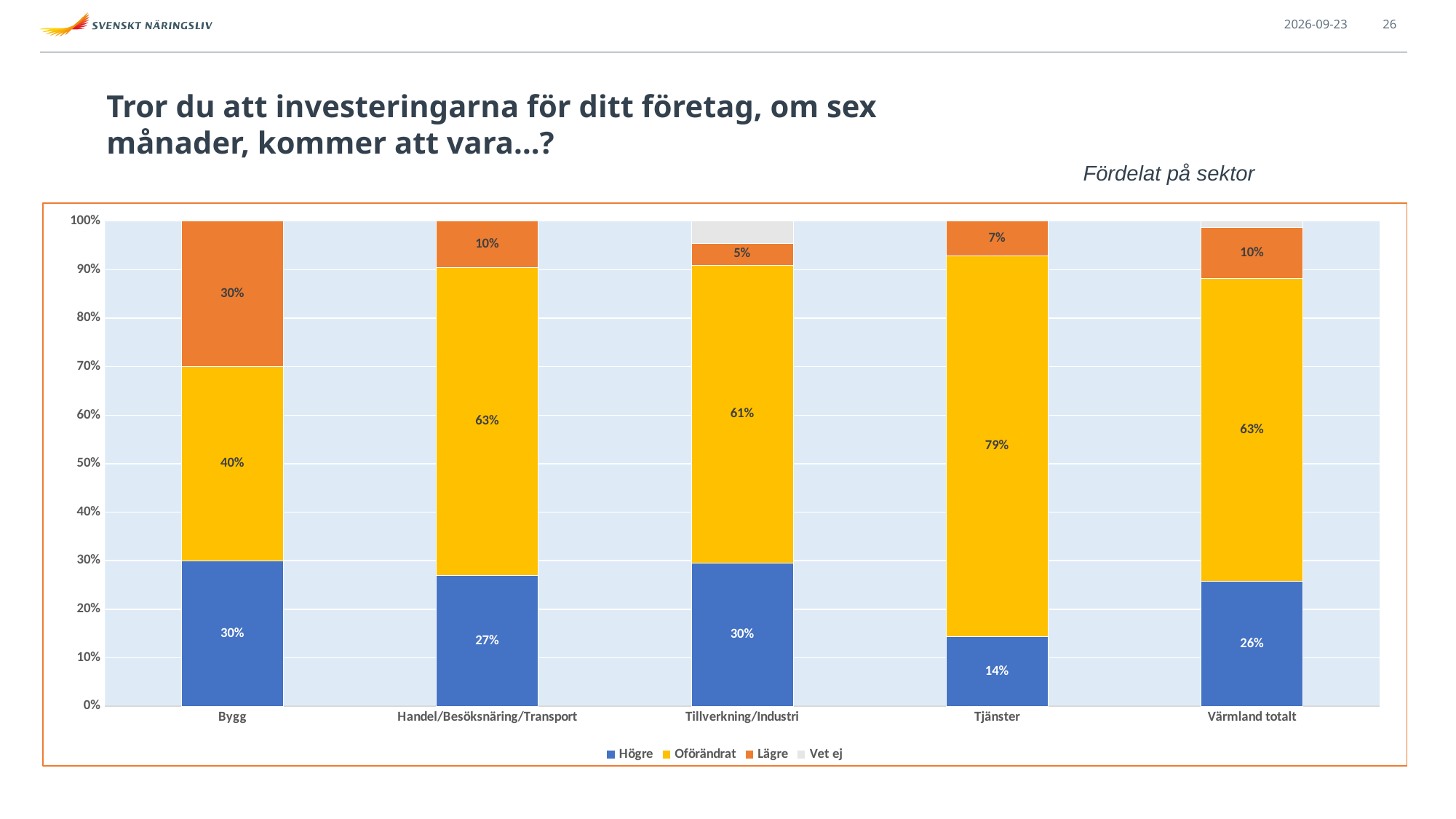
Which sector has the lowest Högre value? Tjänster What kind of chart is shown on the slide? Stacked bar chart What is the value of Oförändrat for Tillverkning/Industri? 61% How many sectors (categories) are shown on the x axis? 5 What is the difference between the Lägre value for Bygg and the Lägre value for Tjänster? 23% How many series does the legend list? 4 Which sector has the highest Oförändrat value? Tjänster What is the value of Oförändrat for Värmland totalt? 63% Which series is shown in orange in the legend? Lägre Which is larger: the Högre value for Handel/Besöksnäring/Transport or the Högre value for Tillverkning/Industri? Tillverkning/Industri What is the value of Högre for Tjänster? 14% What is the value of Lägre for Bygg? 30%